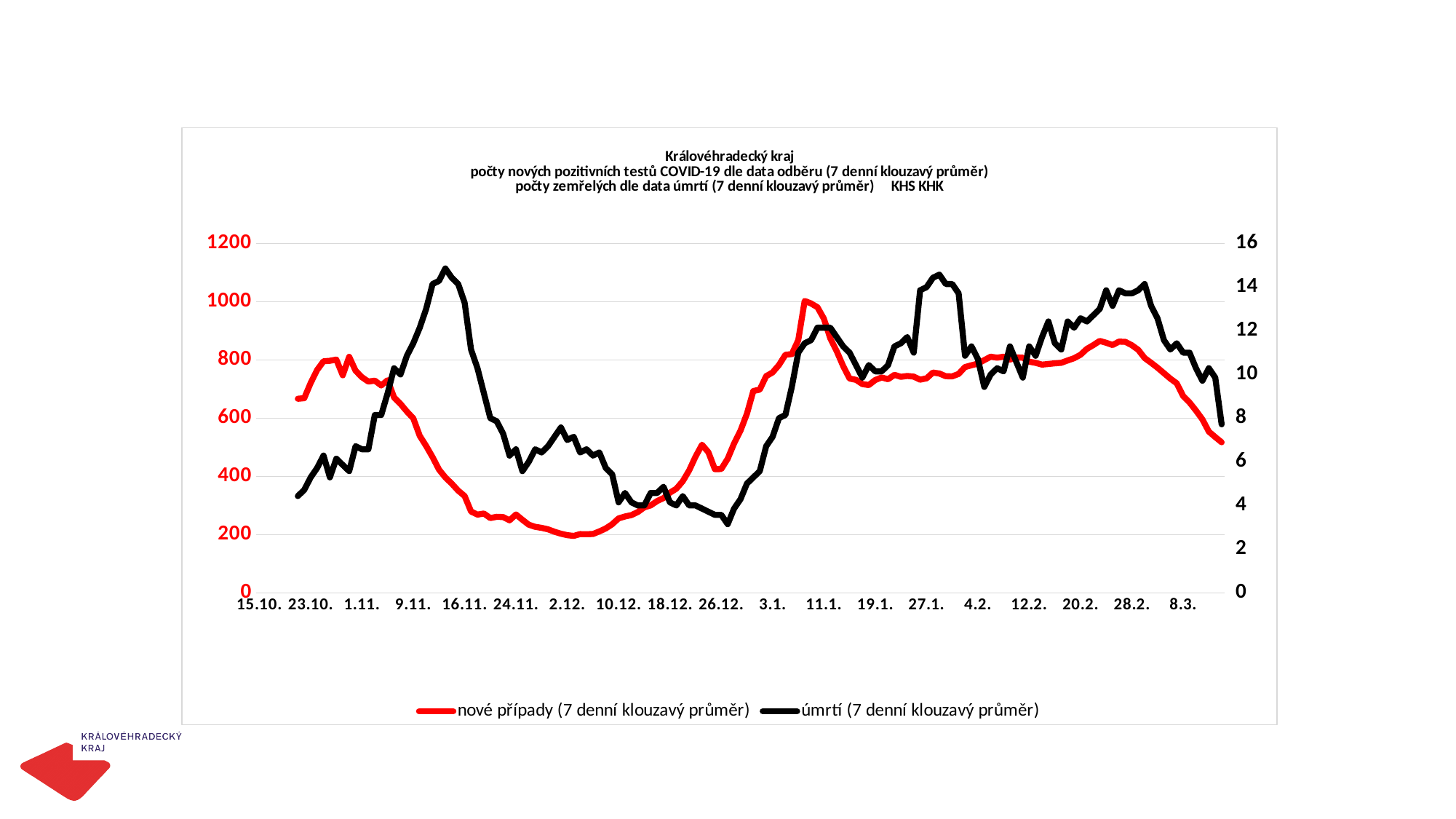
Which series is drawn in red according to the legend? nové případy (7 denní klouzavý průměr) How many date labels are shown on the x axis? 19 Is the value of the black line (úmrtí) at 16.11. greater or less than 12? greater What is the highest value shown on the left vertical axis? 1200 Does the red line (nové případy) rise or fall between 2.12. and 11.1.? rise What kind of chart is shown on the slide? line chart Is the value of the black line (úmrtí) at 26.12. greater or less than 6? less Is the value of the red line (nové případy) at 10.12. greater or less than 400? less Which is larger for the red line (nové případy): the value at 2.12. or the value at 11.1.? 11.1. Does the red line (nové případy) rise or fall between 1.11. and 2.12.? fall How many series does the legend list? 2